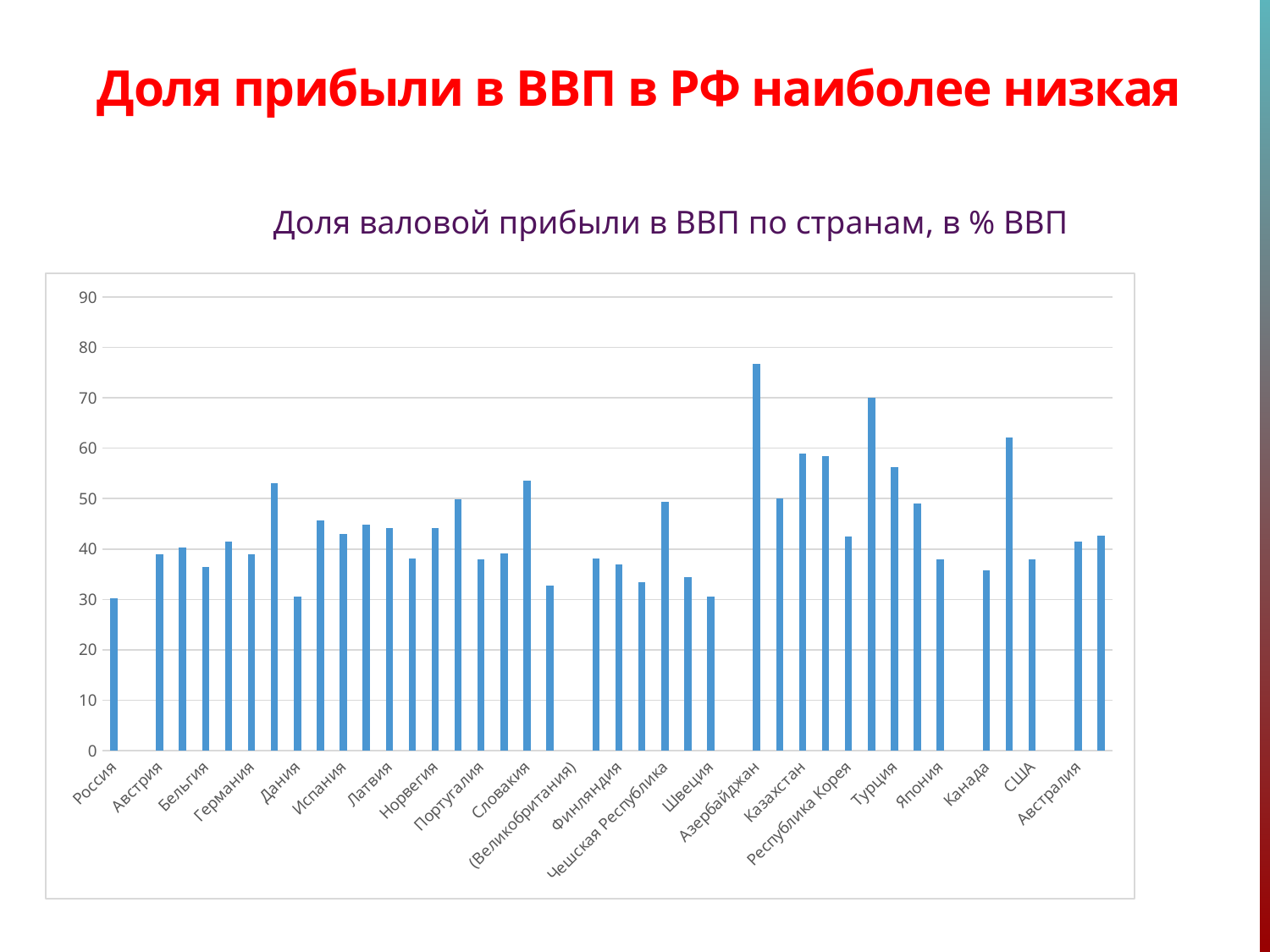
Is the value for Словакия greater or less than 50? greater Which country has the highest share of gross profit in GDP on the chart? Азербайджан What is the title of the chart? Доля валовой прибыли в ВВП по странам, в % ВВП Which is larger, the value for Словакия or the value for Финляндия? Словакия Which is larger, the value for Турция or the value for Япония? Турция Is the value for Азербайджан greater or less than 70? greater Is the value for Казахстан greater or less than 50? greater What kind of chart is shown on the slide? bar chart Which is larger, the value for Азербайджан or the value for Казахстан? Азербайджан